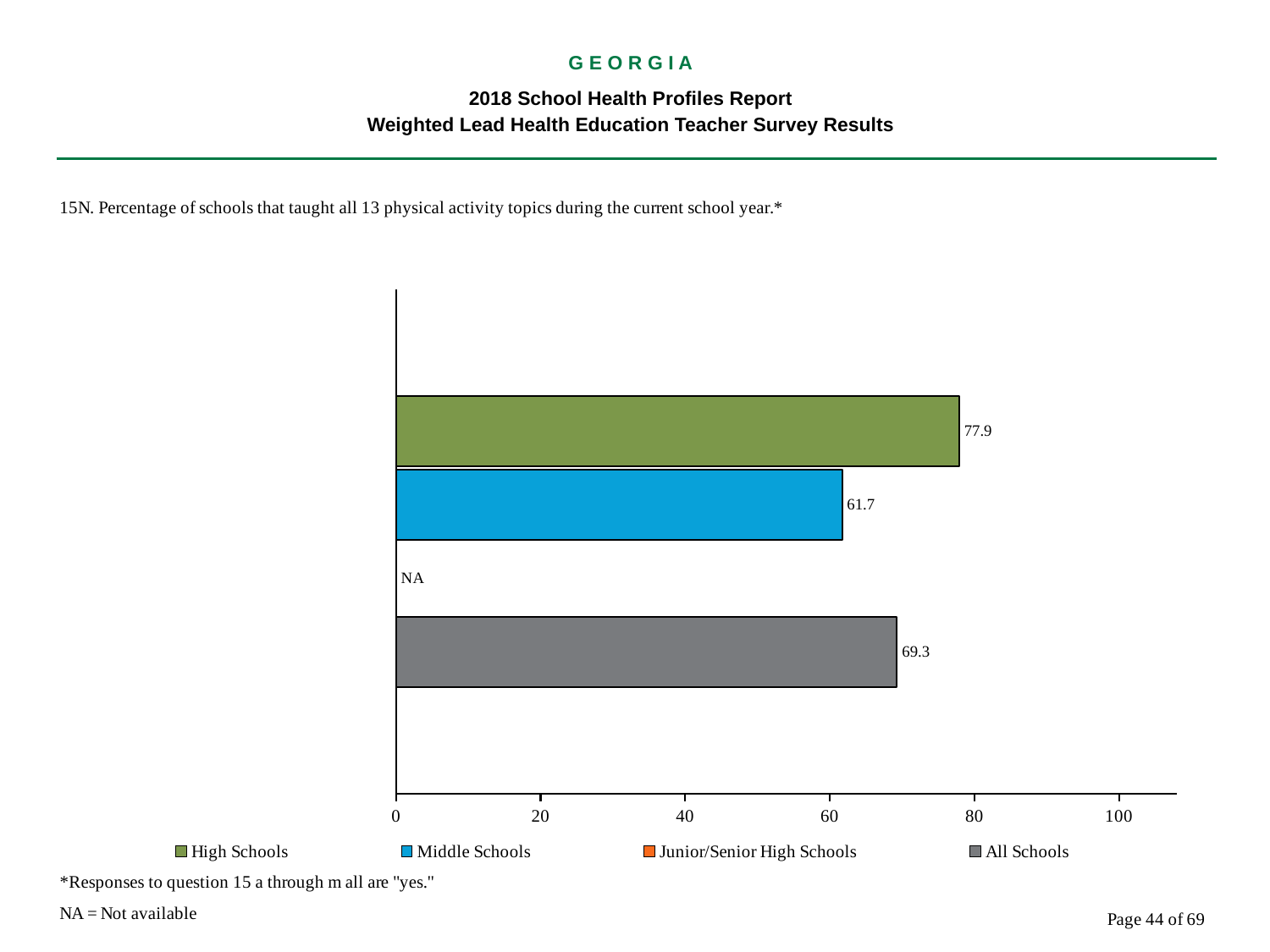
What is the value for All Schools? 69.3 How many series does the legend list? 4 What is shown for Junior/Senior High Schools? NA What kind of chart is shown? bar chart Is the value for High Schools greater or less than 80? less What is the difference between the High Schools and All Schools values? 8.6 What is the value for High Schools? 77.9 What is the difference between the High Schools and Middle Schools values? 16.2 What is the value for Middle Schools? 61.7 Which school type has the highest value? High Schools Which is larger, the value for Middle Schools or the value for All Schools? All Schools Which school type with a plotted value has the lowest value? Middle Schools